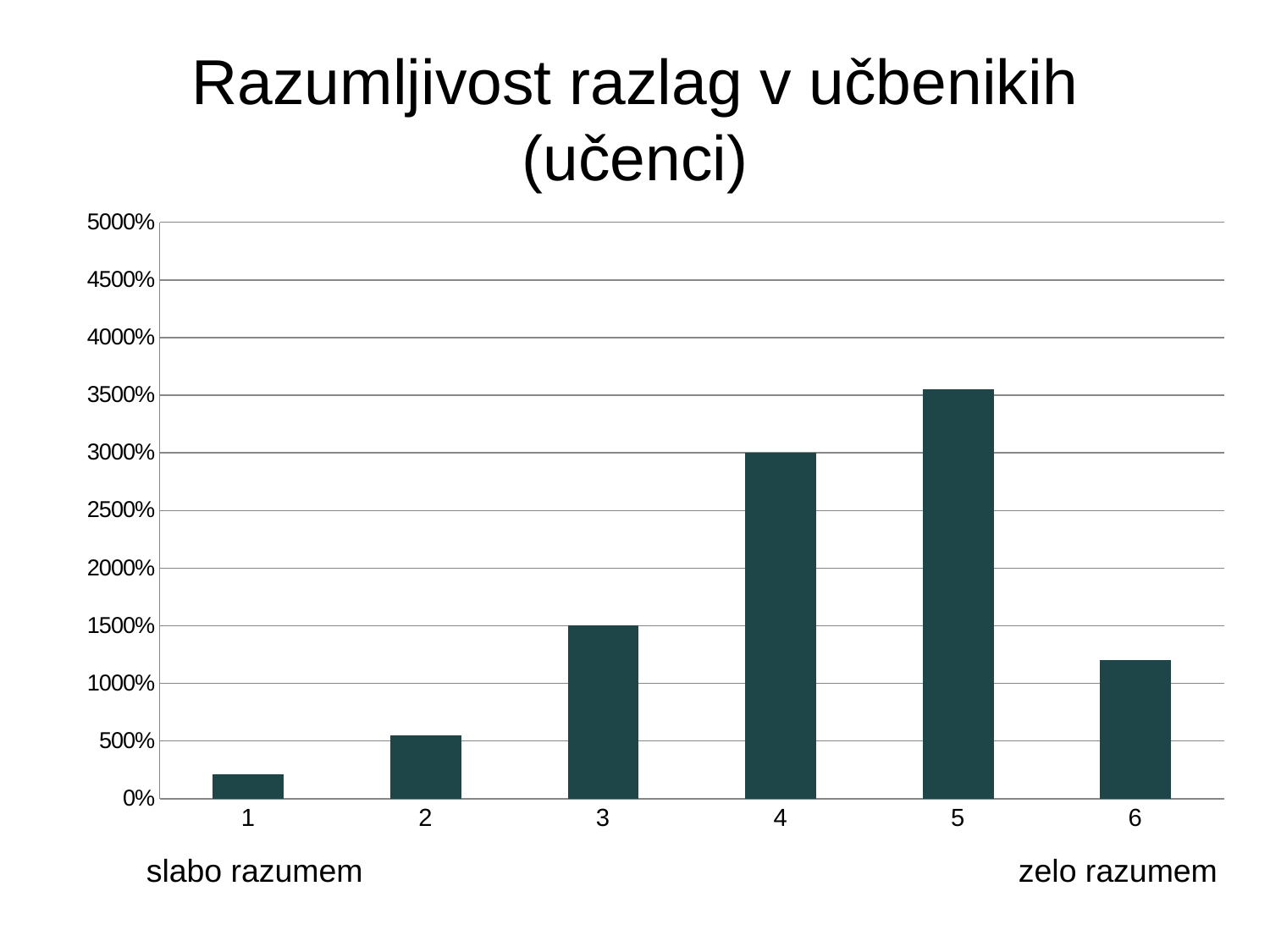
Which category has the highest bar? 5 Which category has the lowest bar? 1 What is the title of the chart? Razumljivost razlag v učbenikih (učenci) What is the difference between the values for category 4 and category 3? 1500% How many categories are plotted on the x axis? 6 Is the value for category 6 greater or less than 1000%? greater What is the value for category 3? 1500% What kind of chart is shown on the slide? bar chart Is the value for category 1 greater or less than 500%? less What is the value for category 4? 3000% Which is larger, the value for category 2 or the value for category 6? 6